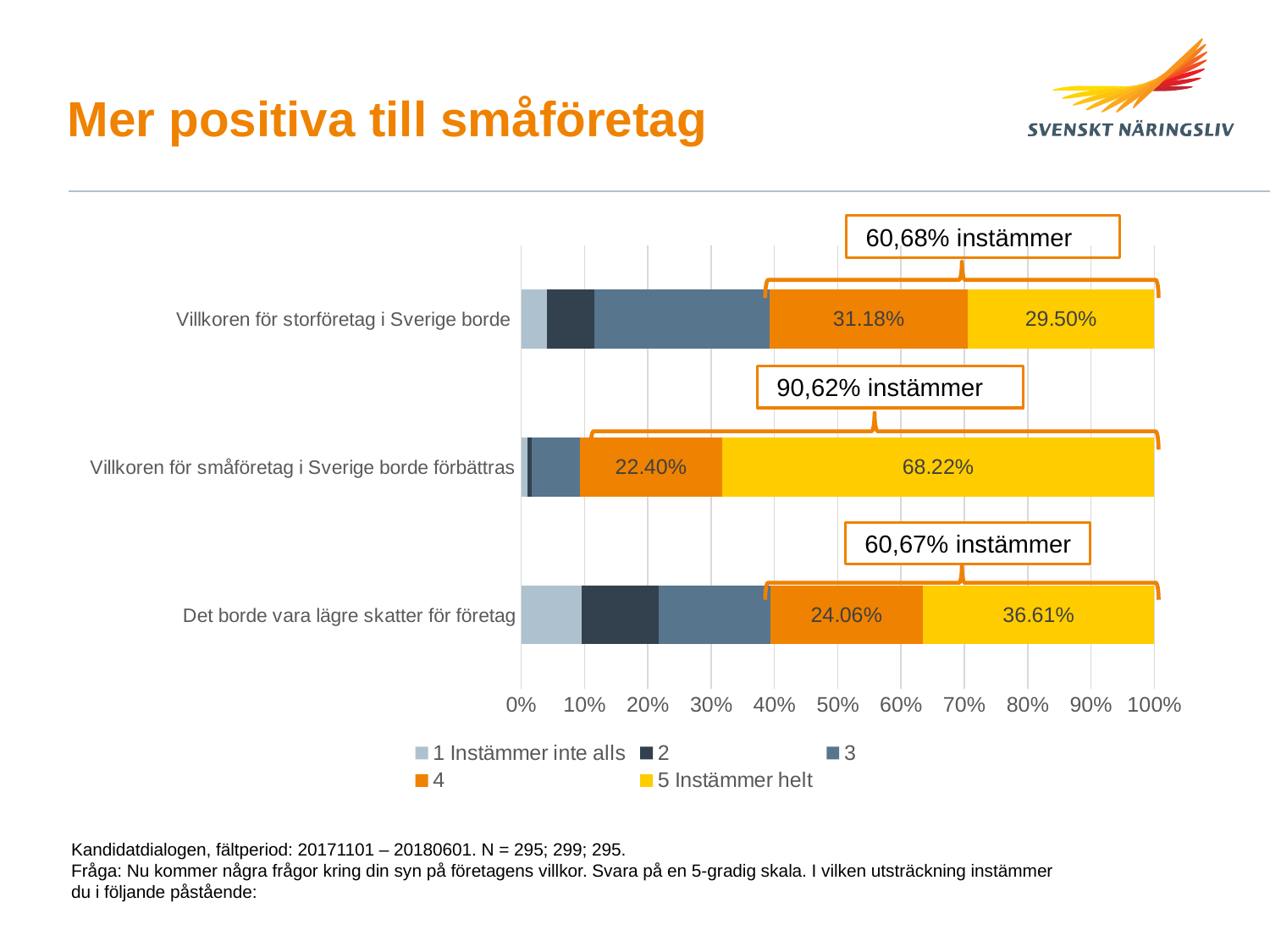
How many statements (categories) are shown in the chart? 3 Which statement has the lowest value for series "4"? Villkoren för småföretag i Sverige borde förbättras What is the value for "5 Instämmer helt" for "Det borde vara lägre skatter för företag"? 36.61% What percentage does the annotation above the "Villkoren för småföretag i Sverige borde förbättras" bar say agree (instämmer)? 90,62% What is the difference between the "5 Instämmer helt" values for "Villkoren för småföretag i Sverige borde förbättras" and "Villkoren för storföretag i Sverige borde"? 38.72% What kind of chart is shown on the slide? Stacked bar chart Which is larger: the "5 Instämmer helt" value for "Villkoren för storföretag i Sverige borde" or for "Det borde vara lägre skatter för företag"? Det borde vara lägre skatter för företag How many series does the legend list? 5 What is the value for "5 Instämmer helt" for "Villkoren för småföretag i Sverige borde förbättras"? 68.22% Is the combined share of series 1, 2 and 3 for "Det borde vara lägre skatter för företag" greater or less than 30%? greater Which statement has the highest value for "5 Instämmer helt"? Villkoren för småföretag i Sverige borde förbättras What is the value for series "4" for "Villkoren för storföretag i Sverige borde"? 31.18%